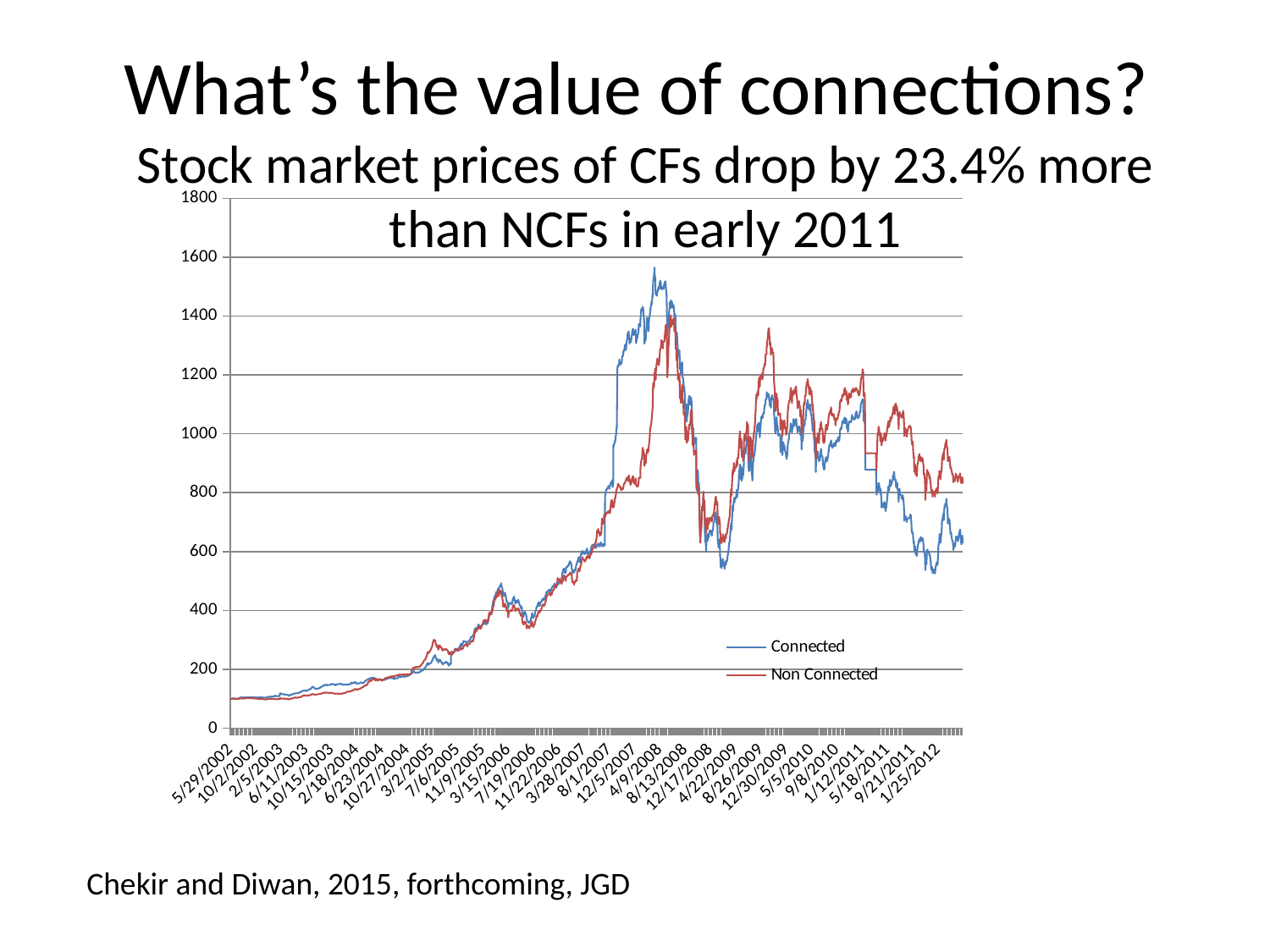
How many series does the legend list? 2 At the end of the period (early 2012), which series has the higher value, Connected or Non Connected? Non Connected Do both series generally rise or fall from 2002 to early 2008? rise Does the Connected series rise or fall between early 2011 and early 2012? fall Is the value of the Connected series at the end of the period (early 2012) greater or less than 800? less What colour is the Connected series line? blue What kind of chart is shown on the slide? line chart What are the two series named in the legend? Connected and Non Connected Are the starting values of both series in 2002 greater or less than 200? less Is the peak value of the Connected series greater or less than 1400? greater Which series reaches the highest peak value over the whole period? Connected